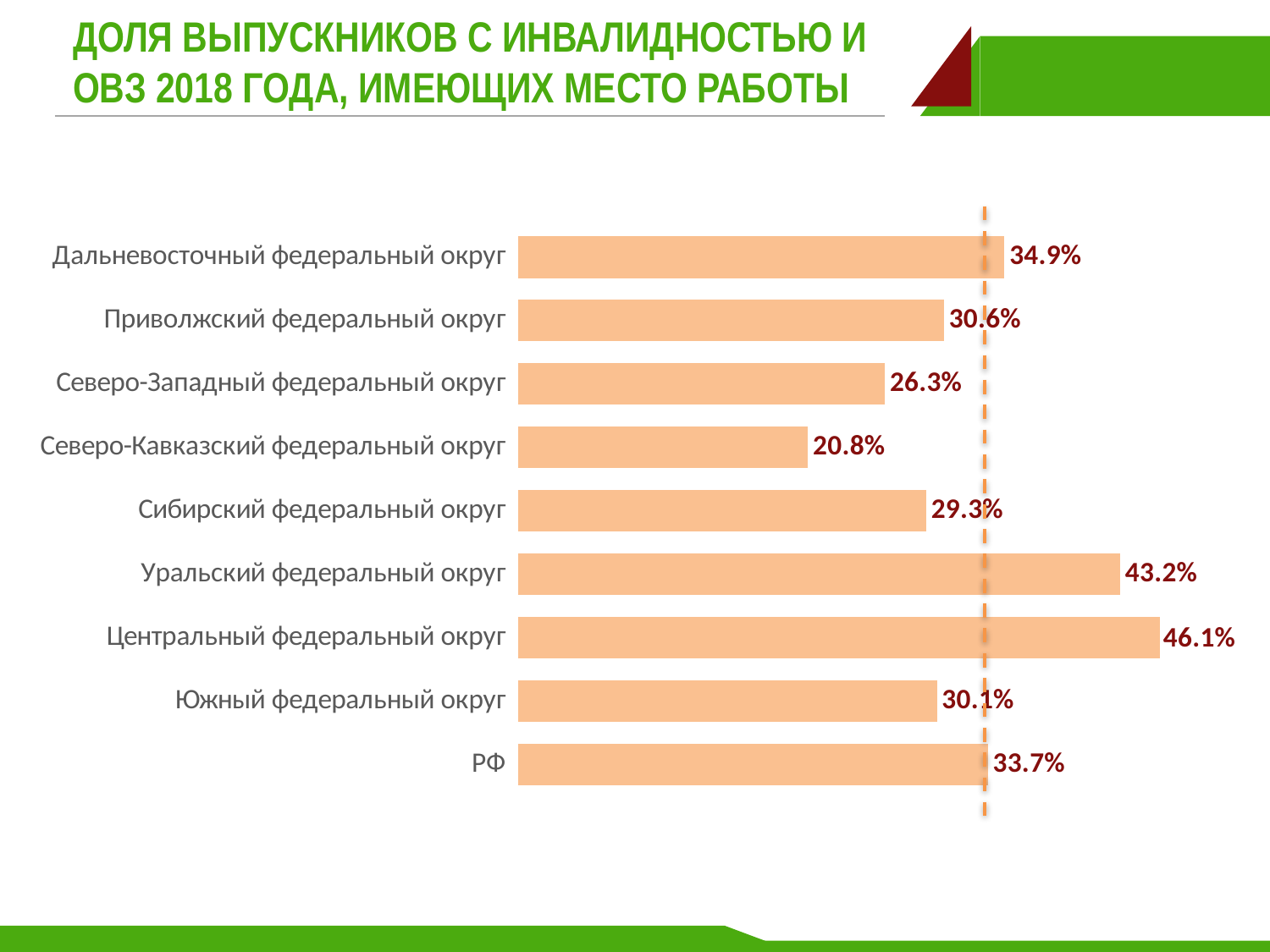
Which category has the highest value? Центральный федеральный округ Which category has the lowest value? Северо-Кавказский федеральный округ What kind of chart is shown on the slide? bar chart Which is larger, the value for Приволжский федеральный округ or the value for Сибирский федеральный округ? Приволжский федеральный округ What is the title of the slide? ДОЛЯ ВЫПУСКНИКОВ С ИНВАЛИДНОСТЬЮ И ОВЗ 2018 ГОДА, ИМЕЮЩИХ МЕСТО РАБОТЫ What is the value for Северо-Кавказский федеральный округ? 20.8% How many categories are shown in the chart? 9 What is the value for Центральный федеральный округ? 46.1% What is the difference between the values for Центральный федеральный округ and Уральский федеральный округ? 2.9% What is the difference between the values for Дальневосточный федеральный округ and РФ? 1.2% What is the value for РФ? 33.7% What is the value for Уральский федеральный округ? 43.2%